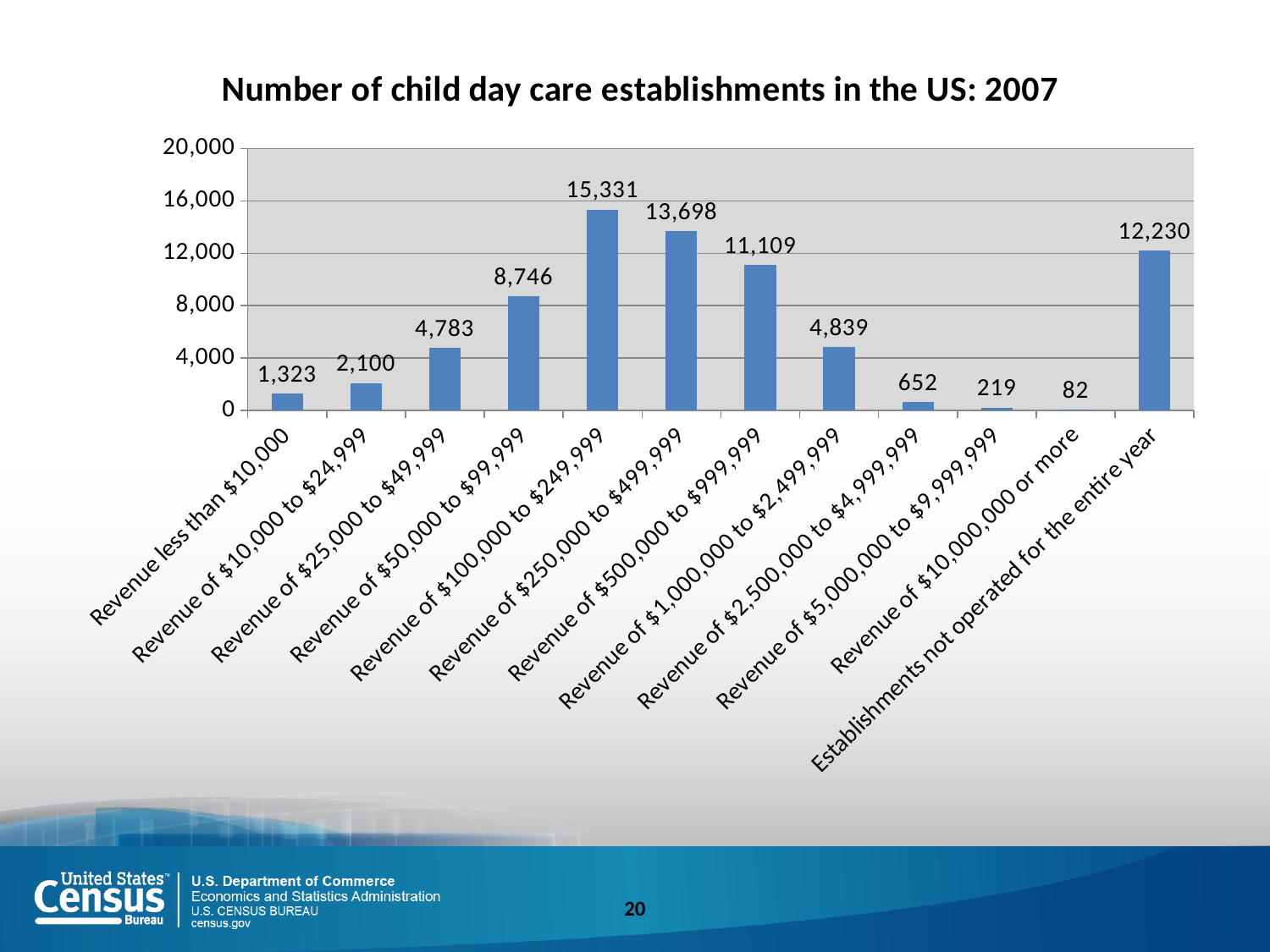
How many child day care establishments had revenue of $100,000 to $249,999? 15,331 Is the value for establishments with revenue of $50,000 to $99,999 greater or less than 8,000? greater What is the title of the chart? Number of child day care establishments in the US: 2007 How many establishments were not operated for the entire year? 12,230 Which revenue category has the highest number of establishments? Revenue of $100,000 to $249,999 What is the value for establishments with revenue of $10,000,000 or more? 82 Which category has the lowest number of establishments? Revenue of $10,000,000 or more What is the difference between the number of establishments with revenue of $10,000 to $24,999 and those with revenue less than $10,000? 777 How many categories are shown on the x axis? 12 What is the difference between the number of establishments with revenue of $250,000 to $499,999 and those with revenue of $500,000 to $999,999? 2,589 What type of chart is shown on the slide? Bar chart Which is larger: the number of establishments with revenue of $25,000 to $49,999 or with revenue of $1,000,000 to $2,499,999? Revenue of $1,000,000 to $2,499,999